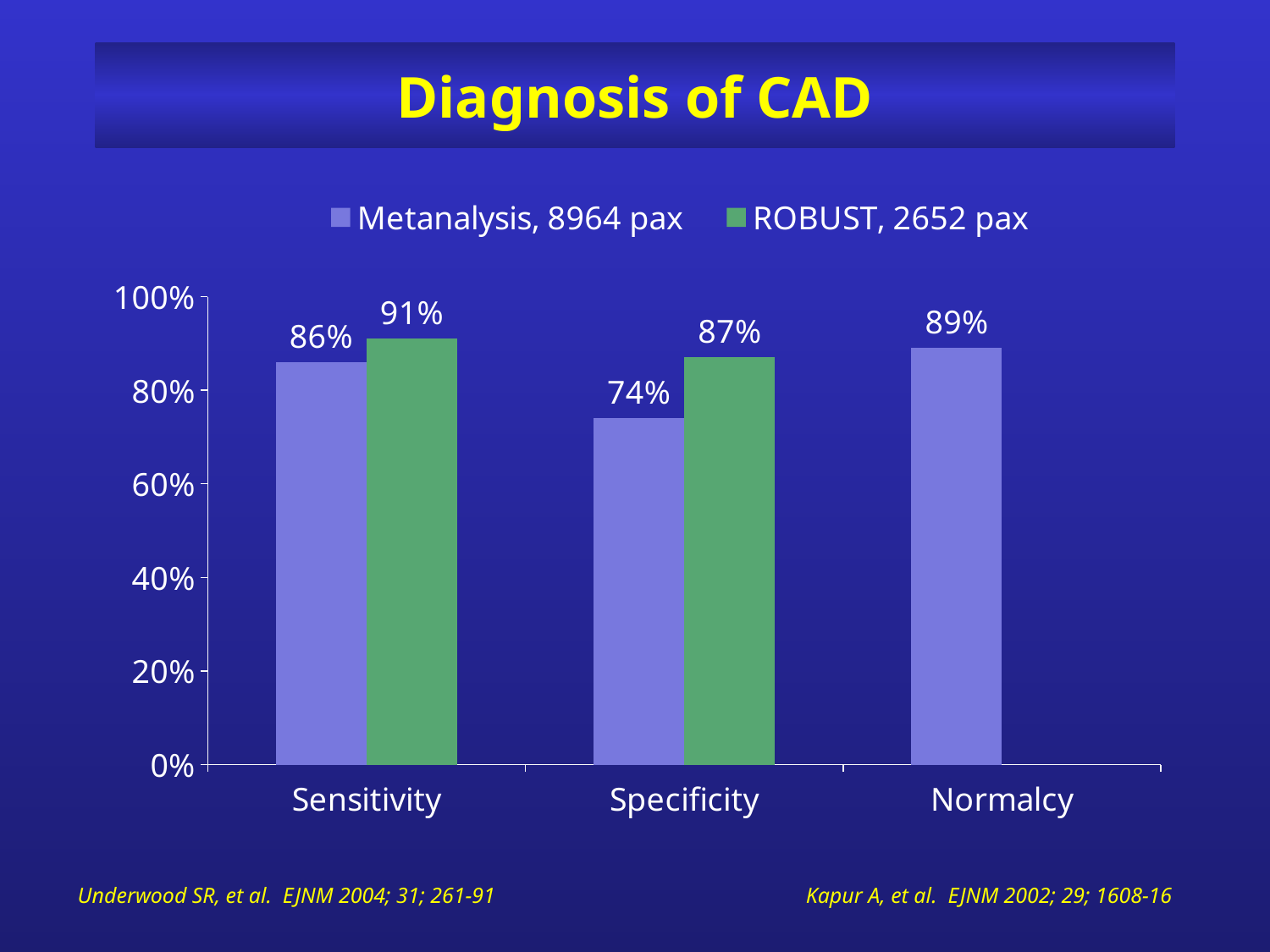
What is the Normalcy value for the Metanalysis, 8964 pax series? 89% What is the Sensitivity value for the Metanalysis, 8964 pax series? 86% Which category has the highest value for the Metanalysis, 8964 pax series? Normalcy What is the Sensitivity value for the ROBUST, 2652 pax series? 91% How many categories are shown on the x axis? 3 What is the Specificity value for the ROBUST, 2652 pax series? 87% What kind of chart is shown on the slide? bar chart Is the Metanalysis, 8964 pax value for Specificity greater or less than 80%? less For Sensitivity, which series has the larger value, Metanalysis, 8964 pax or ROBUST, 2652 pax? ROBUST, 2652 pax How many series does the legend list? 2 What is the difference between the ROBUST, 2652 pax and Metanalysis, 8964 pax values for Specificity? 13% Which category has the lowest value for the Metanalysis, 8964 pax series? Specificity